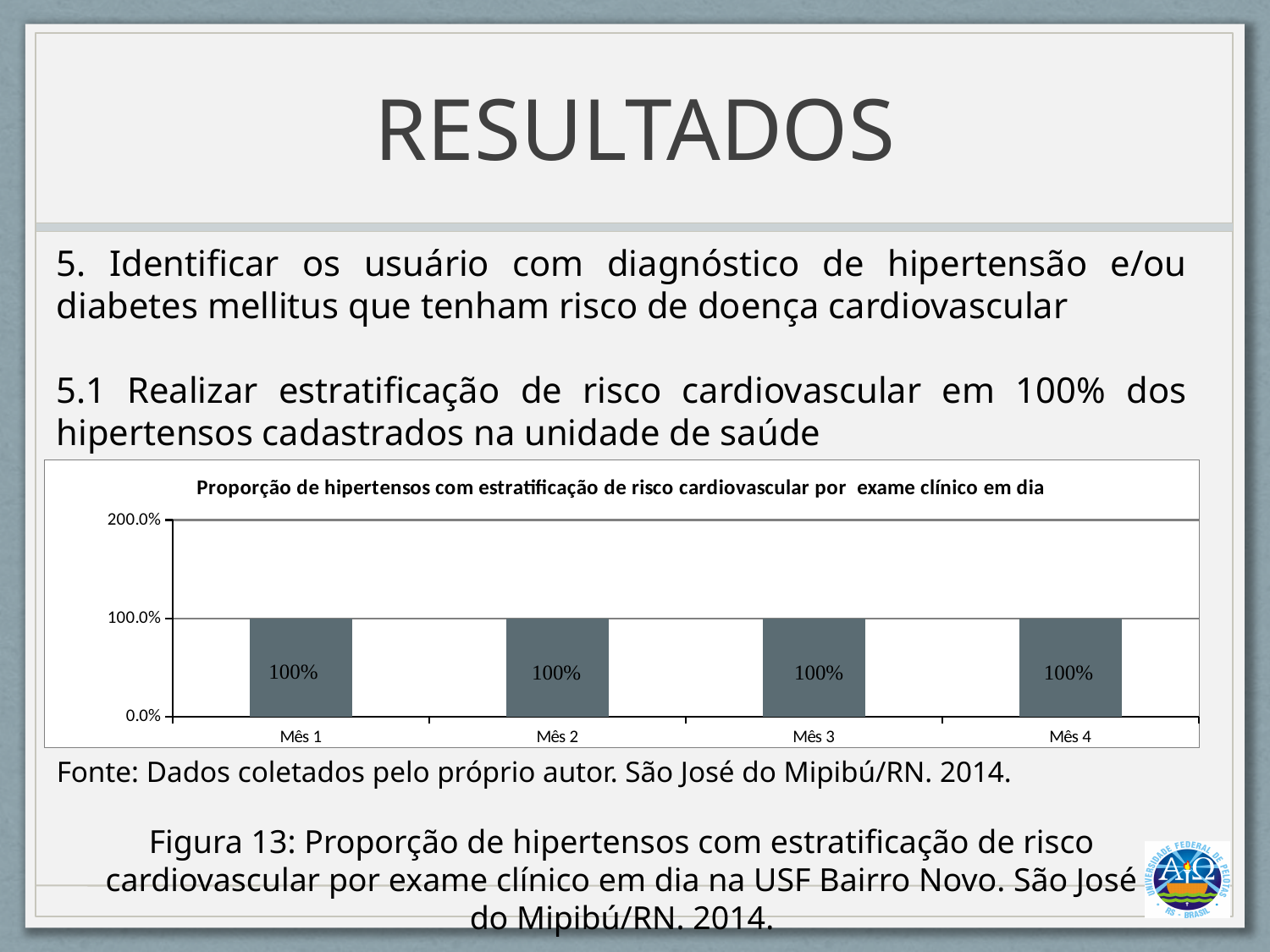
How many months (categories) are shown on the x axis of the chart? 4 Do the values rise, fall, or stay the same from Mês 1 to Mês 4? Stay the same Is the value for Mês 2 greater or less than 200.0%? less What is the value for Mês 3? 100% What kind of chart is shown on the slide? Bar chart What is the value for Mês 2? 100% What is the highest tick value shown on the y axis of the chart? 200.0% What is the title of the chart? Proporção de hipertensos com estratificação de risco cardiovascular por exame clínico em dia What is the value for Mês 4? 100% What is the value for Mês 1? 100% What is the difference between the values for Mês 1 and Mês 4? 0%